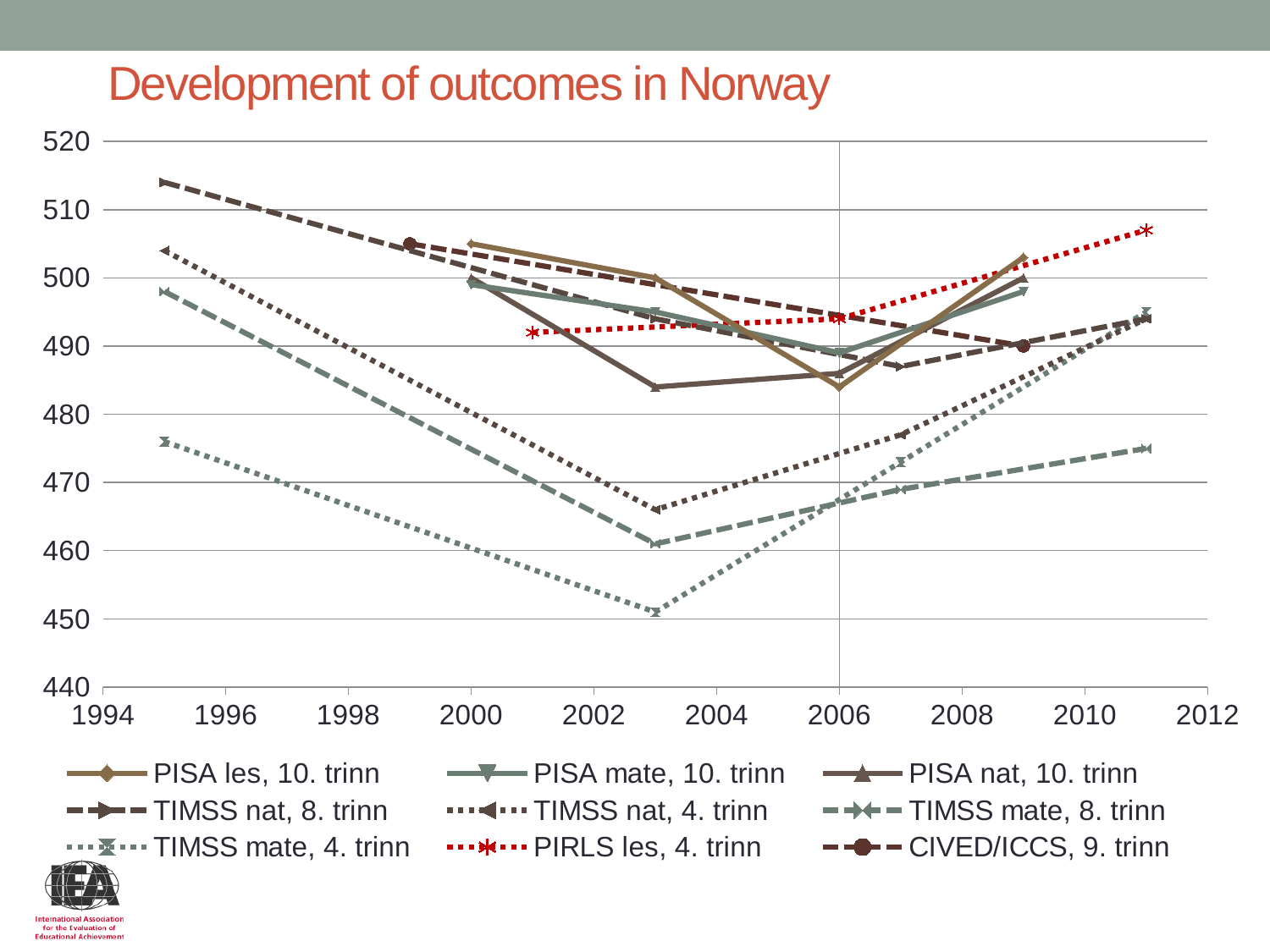
Is the value for TIMSS mate, 4. trinn in 2003 greater or less than 460? less Is the value for TIMSS mate, 8. trinn in 2011 greater or less than 480? less How many series does the legend list? 9 Is the value for TIMSS nat, 8. trinn in 1995 greater or less than 510? greater Which series has the highest point on the chart? TIMSS nat, 8. trinn What kind of chart is shown on the slide? line chart How many data points are plotted for PIRLS les, 4. trinn? 3 What is the title of the chart? Development of outcomes in Norway Do the values for PIRLS les, 4. trinn rise or fall from 2001 to 2011? rise Which series has the lowest point on the chart? TIMSS mate, 4. trinn Do the values for CIVED/ICCS, 9. trinn rise or fall from 1999 to 2009? fall